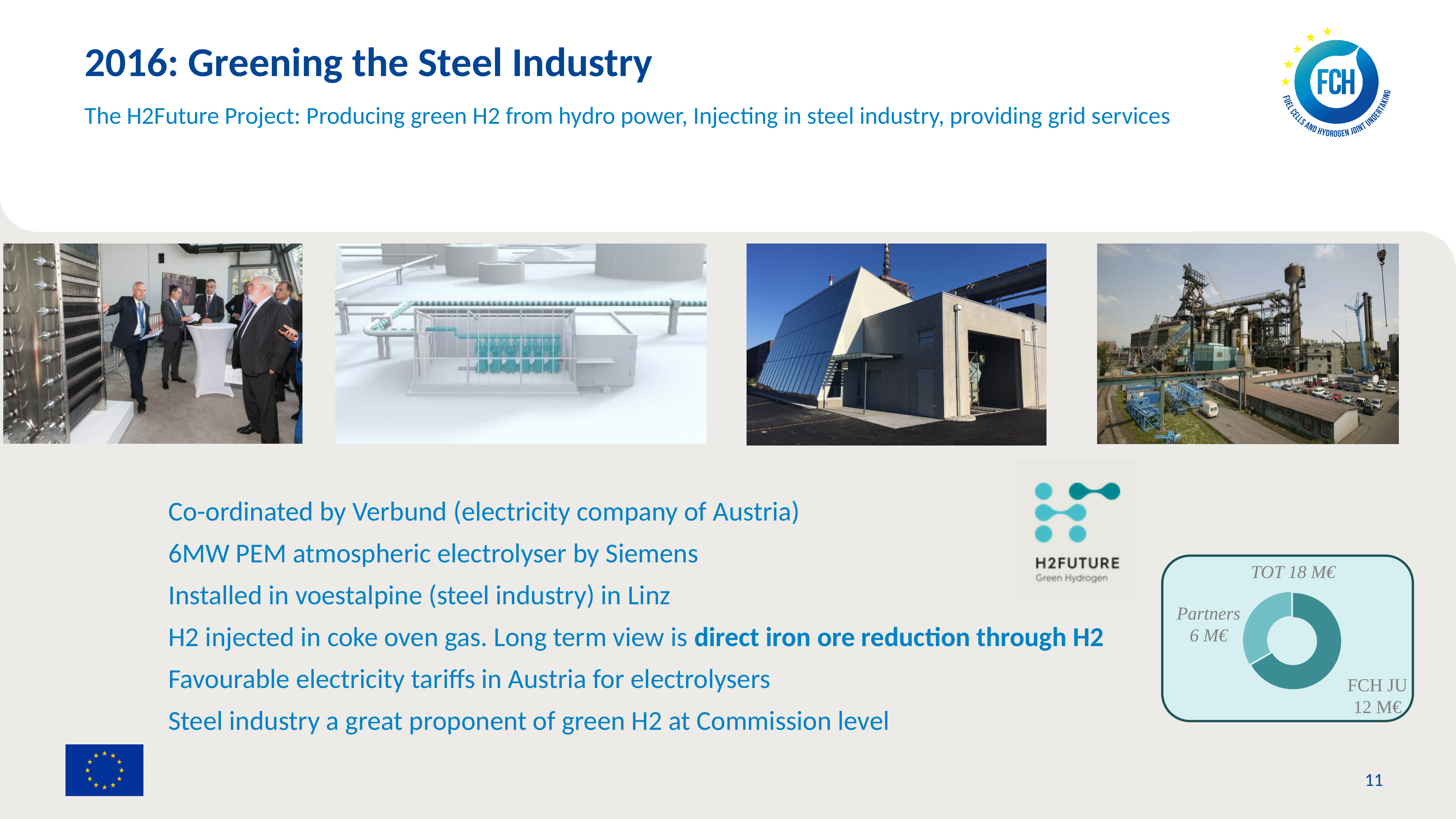
How much funding do the Partners contribute according to the donut chart? 6 M€ What is the difference between the FCH JU contribution and the Partners contribution? 6 M€ What type of chart is shown on the slide? Donut (pie) chart What label appears above the donut chart? TOT 18 M€ What fraction of the total funding comes from FCH JU? Two thirds (12 M€ of 18 M€) What fraction of the total funding comes from Partners? One third (6 M€ of 18 M€) Which contributor provides the smaller share of funding in the donut chart? Partners How much funding does FCH JU contribute according to the donut chart? 12 M€ Which contributor provides the larger share of funding in the donut chart? FCH JU Is the FCH JU contribution larger or smaller than the Partners contribution? Larger What is the total funding shown in the donut chart? 18 M€ How many segments does the donut chart have? 2